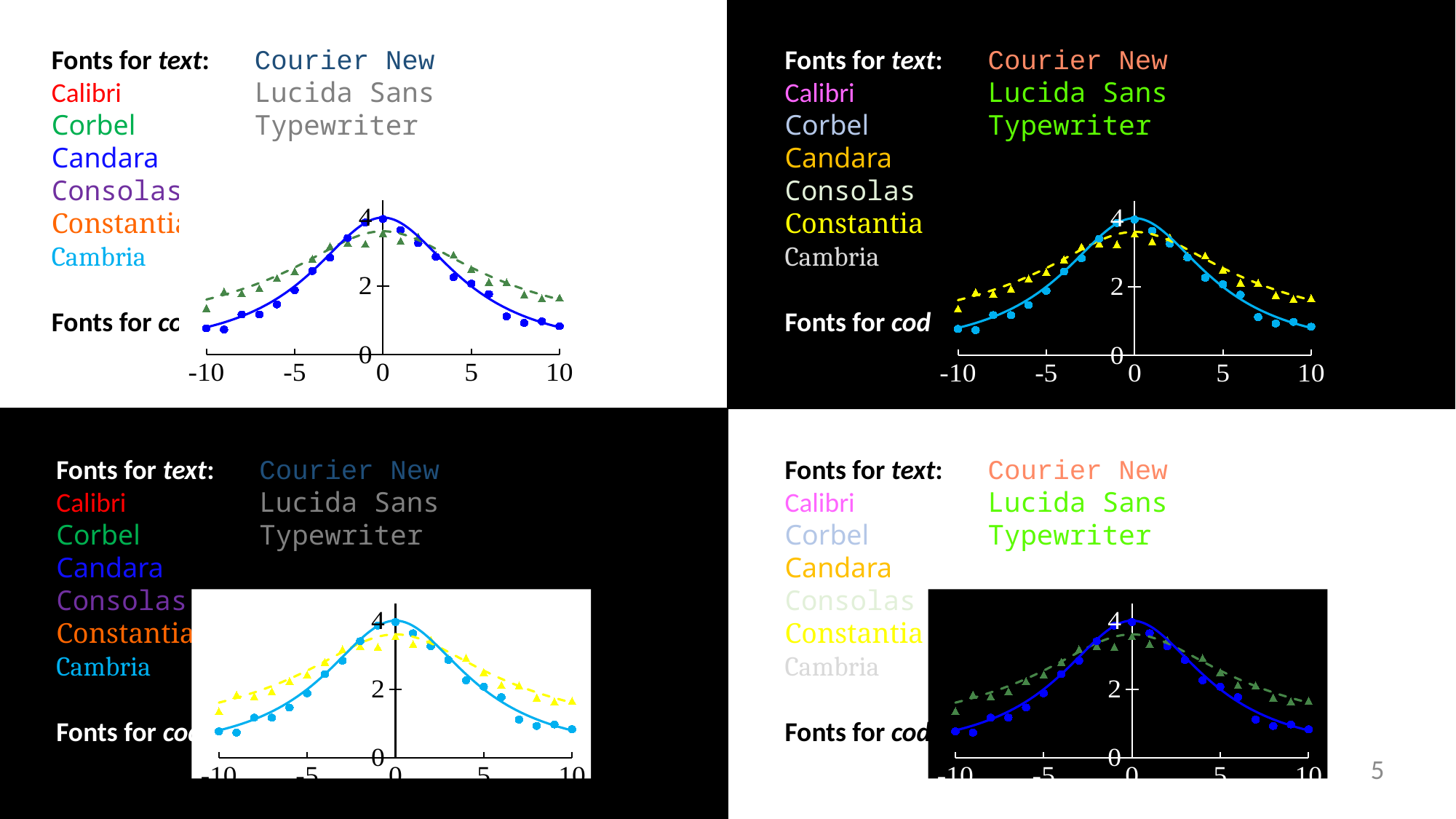
In the top-left chart, is the value of the solid-line series at x = 10 greater or less than 2? less What kind of chart is shown in the top-left panel? line chart In the top-left chart, is the value of the solid-line series at x = 0 greater or less than 2? greater In the top-left chart, how many data series are plotted? 4 In the bottom-left chart, do the values of the solid-line series rise or fall as x goes from -10 to 0? rise In the top-left chart, at x = -10, which series is higher: the solid line with circles or the dashed line with triangles? the dashed line with triangles What is the range of the x axis shown in the top-right chart? -10 to 10 In the top-left chart, at x = 0, which series is higher: the solid line with circles or the dashed line with triangles? the solid line with circles How many charts are shown on the slide? 4 In the bottom-right chart, is the value of the dashed-line series at x = 0 greater or less than 2? greater What is the highest value labelled on the y axis of the bottom-right chart? 4 In the top-right chart, do the values of the solid-line series rise or fall as x goes from 0 to 10? fall